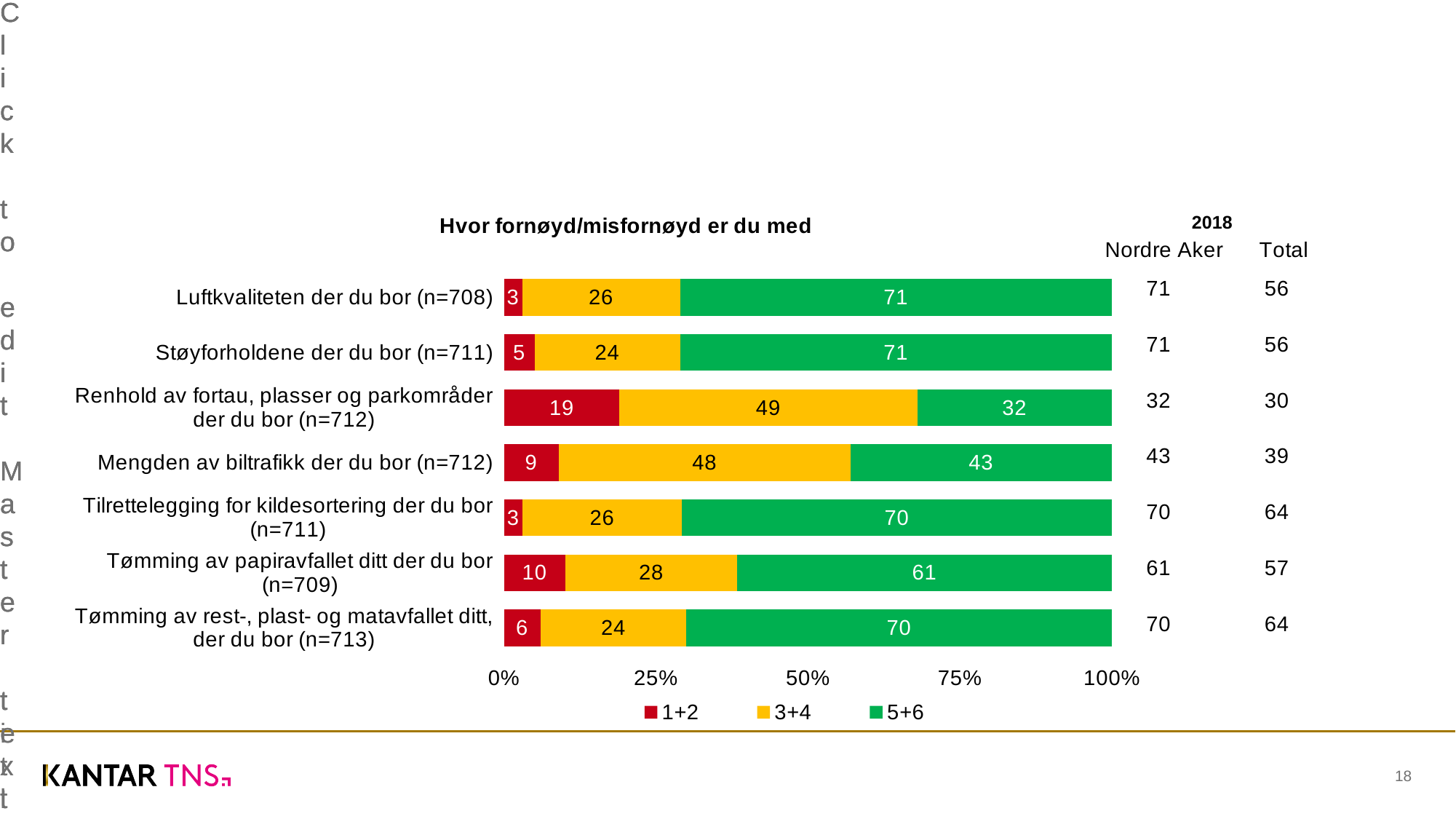
What is the 5+6 value for 'Luftkvaliteten der du bor (n=708)'? 71 What is the 3+4 value for 'Mengden av biltrafikk der du bor (n=712)'? 48 What is the difference between the 5+6 values for 'Mengden av biltrafikk der du bor (n=712)' and 'Renhold av fortau, plasser og parkområder der du bor (n=712)'? 11 What is the 1+2 value for 'Tømming av papiravfallet ditt der du bor (n=709)'? 10 Which category has the highest 1+2 value? Renhold av fortau, plasser og parkområder der du bor (n=712) What is the total of the stacked bar for 'Tømming av papiravfallet ditt der du bor (n=709)'? 99 How many series does the legend list? 3 How many categories are plotted in the chart? 7 Which category has the lowest 5+6 value? Renhold av fortau, plasser og parkområder der du bor (n=712) Which is larger: the 3+4 value for 'Renhold av fortau, plasser og parkområder der du bor (n=712)' or for 'Luftkvaliteten der du bor (n=708)'? Renhold av fortau, plasser og parkområder der du bor (n=712) What kind of chart is shown on the slide? Stacked bar chart What is the title of the chart? Hvor fornøyd/misfornøyd er du med